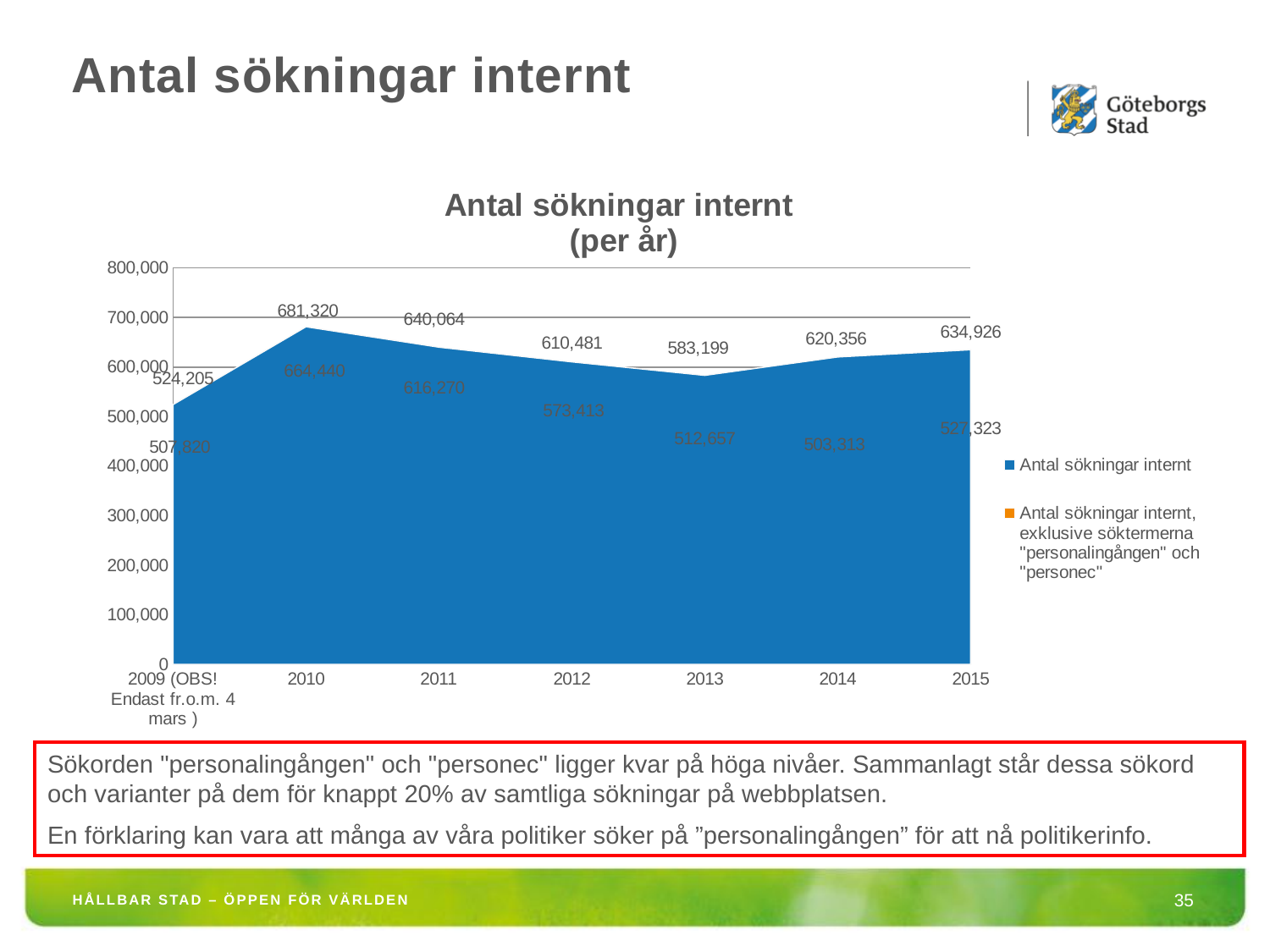
What is the value of "Antal sökningar internt" for 2015? 634,926 How many years are shown on the x axis? 7 Which year has the highest value for "Antal sökningar internt"? 2010 What kind of chart is shown? Area chart Is the value for "Antal sökningar internt" in 2012 greater or less than 600,000? greater What is the value of "Antal sökningar internt" for 2013? 583,199 What is the value of "Antal sökningar internt" for 2010? 681,320 How many series does the legend list? 2 Which year has the lowest value for "Antal sökningar internt"? 2009 (OBS! Endast fr.o.m. 4 mars ) Which is larger for "Antal sökningar internt": 2014 or 2015? 2015 What is the title of the chart? Antal sökningar internt (per år) What is the difference between the "Antal sökningar internt" values for 2010 and 2011? 41,256